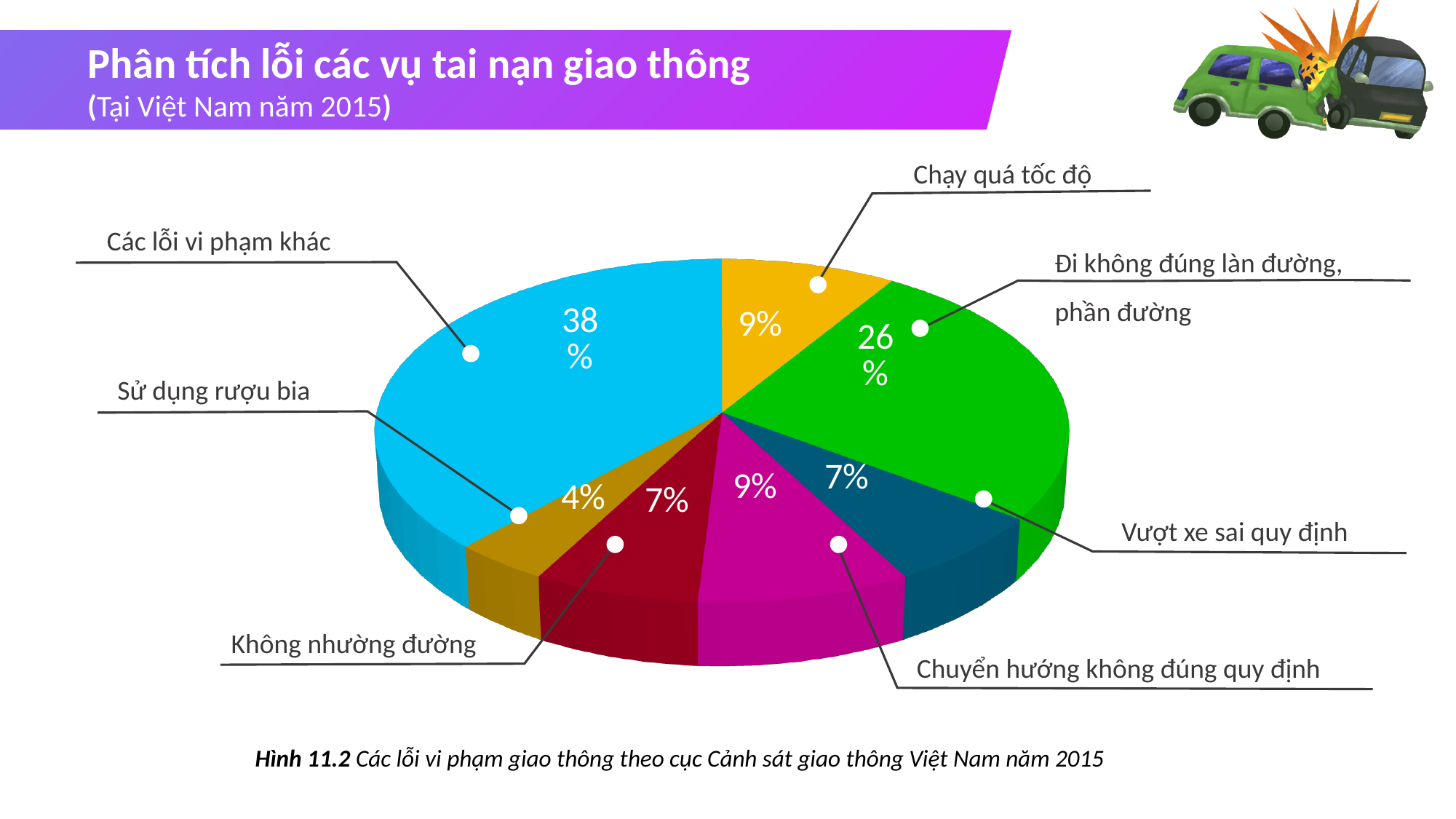
Which is larger, the value for "Chuyển hướng không đúng quy định" or the value for "Không nhường đường"? Chuyển hướng không đúng quy định What is the figure caption below the chart? Hình 11.2 Các lỗi vi phạm giao thông theo cục Cảnh sát giao thông Việt Nam năm 2015 What is the value for "Vượt xe sai quy định"? 7% What is the value for "Sử dụng rượu bia"? 4% What is the difference between the values for "Các lỗi vi phạm khác" and "Đi không đúng làn đường, phần đường"? 12% What is the value for "Chạy quá tốc độ"? 9% Which category has the largest slice of the pie? Các lỗi vi phạm khác What share of the pie does "Các lỗi vi phạm khác" represent? 38% What is the value for "Đi không đúng làn đường, phần đường"? 26% What kind of chart is shown on the slide? pie chart How many slices does the pie chart have? 7 Which category has the smallest slice of the pie? Sử dụng rượu bia